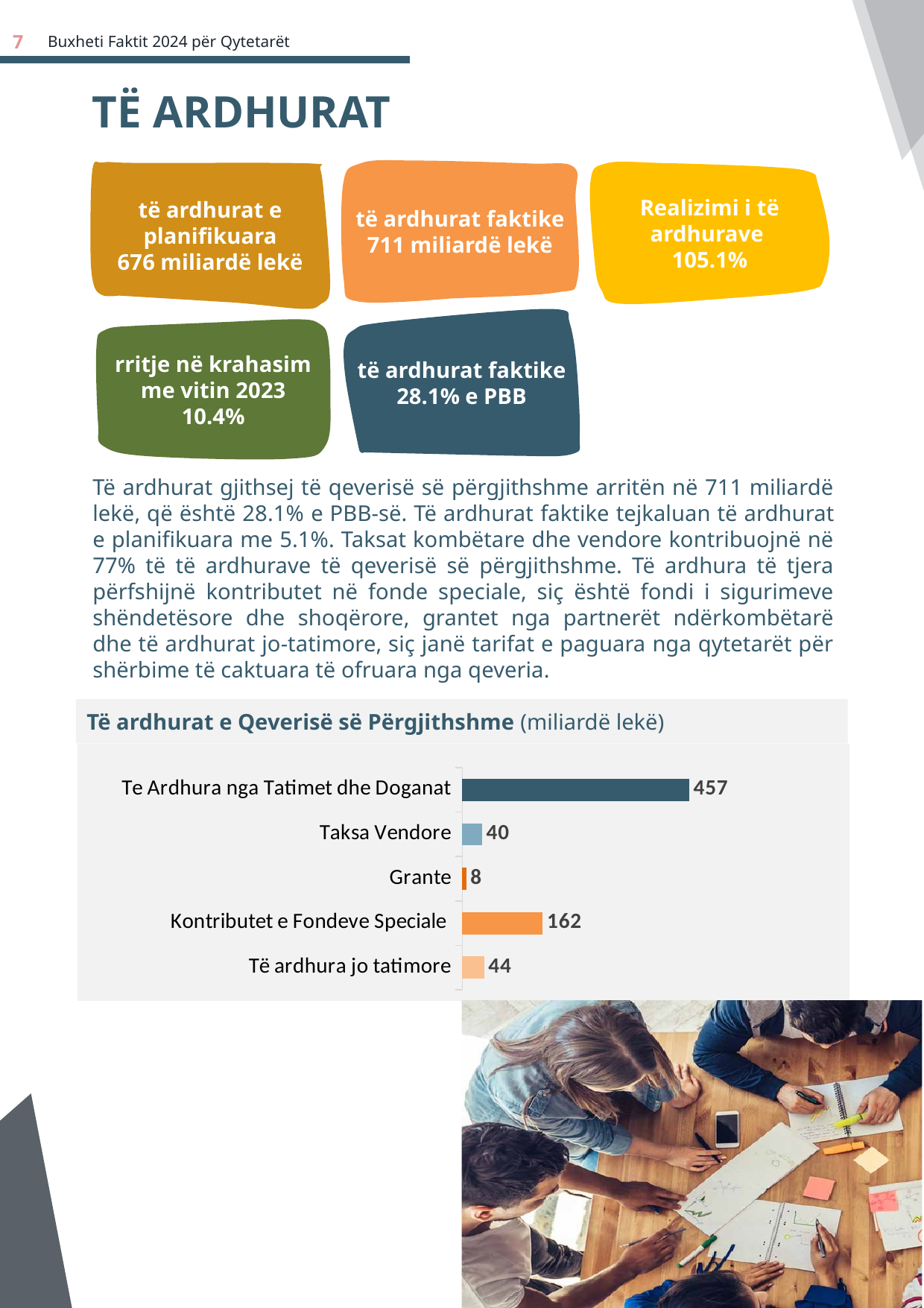
What is the difference between Të ardhura jo tatimore and Taksa Vendore? 4 What is the value for Grante in the chart? 8 What is the difference between Te Ardhura nga Tatimet dhe Doganat and Kontributet e Fondeve Speciale? 295 What kind of chart is shown on the slide? Bar chart Which category has the highest value in the chart? Te Ardhura nga Tatimet dhe Doganat What is the value for Te Ardhura nga Tatimet dhe Doganat in the chart? 457 Which category has the lowest value in the chart? Grante What is the value for Të ardhura jo tatimore in the chart? 44 Which is larger, Taksa Vendore or Kontributet e Fondeve Speciale? Kontributet e Fondeve Speciale How many categories are shown in the chart? 5 What is the value for Kontributet e Fondeve Speciale in the chart? 162 What is the title of the chart? Të ardhurat e Qeverisë së Përgjithshme (miliardë lekë)